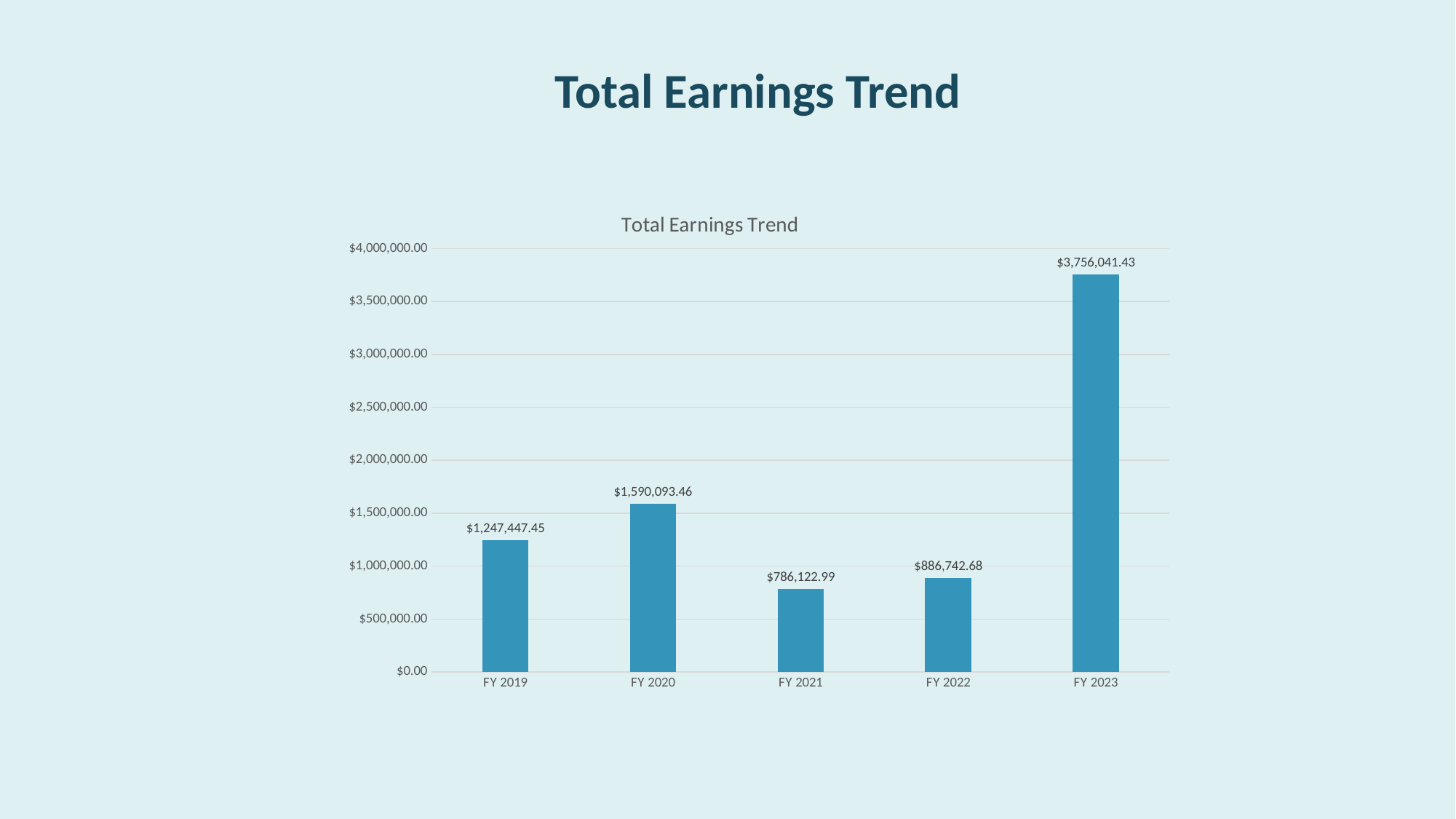
What is the value for FY 2021? $786,122.99 What is the value for FY 2023? $3,756,041.43 Which fiscal year has the lowest total earnings? FY 2021 Which is larger, the value for FY 2020 or the value for FY 2022? FY 2020 What is the difference between the values for FY 2020 and FY 2019? $342,646.01 Which fiscal year has the highest total earnings? FY 2023 Is the value for FY 2022 greater or less than $1,000,000.00? less What is the value for FY 2019? $1,247,447.45 Does the value rise or fall from FY 2020 to FY 2021? fall What is the difference between the values for FY 2023 and FY 2022? $2,869,298.75 How many fiscal years are shown on the x axis? 5 What kind of chart is shown on the slide? bar chart